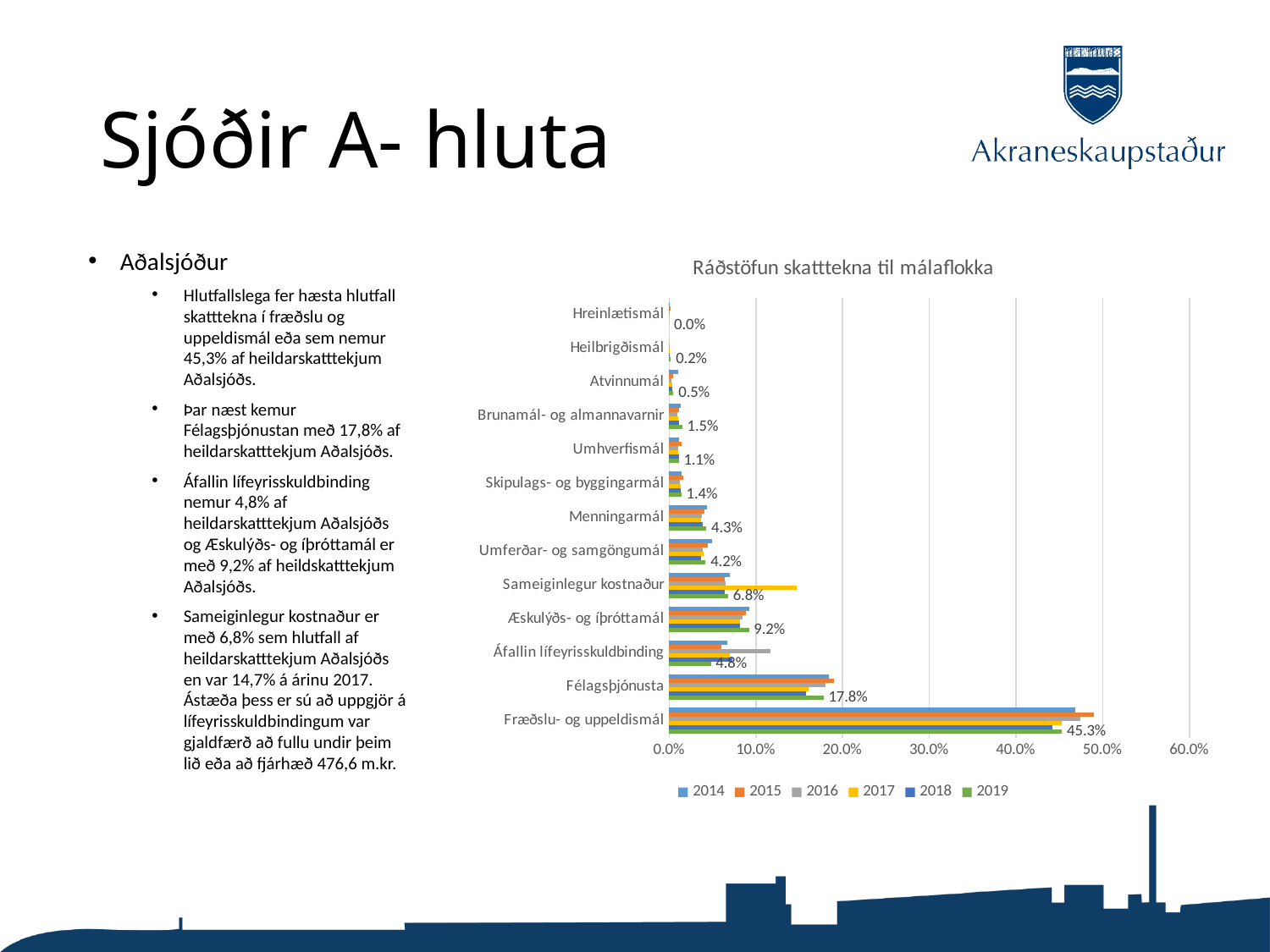
What is the 2019 value for Félagsþjónusta? 17.8% What is the 2019 value for Fræðslu- og uppeldismál? 45.3% How many categories are shown on the chart? 13 Which category has the highest 2019 value? Fræðslu- og uppeldismál Which has the larger 2019 value, Æskulýðs- og íþróttamál or Sameiginlegur kostnaður? Æskulýðs- og íþróttamál What is the 2019 value for Sameiginlegur kostnaður? 6.8% Which category has the lowest 2019 value? Hreinlætismál How many series does the legend list? 6 What is the difference between the 2019 values for Fræðslu- og uppeldismál and Félagsþjónusta? 27.5% What kind of chart is shown on the slide? Bar chart Is the 2017 value for Sameiginlegur kostnaður greater or less than 10.0%? greater What is the 2019 value for Æskulýðs- og íþróttamál? 9.2%